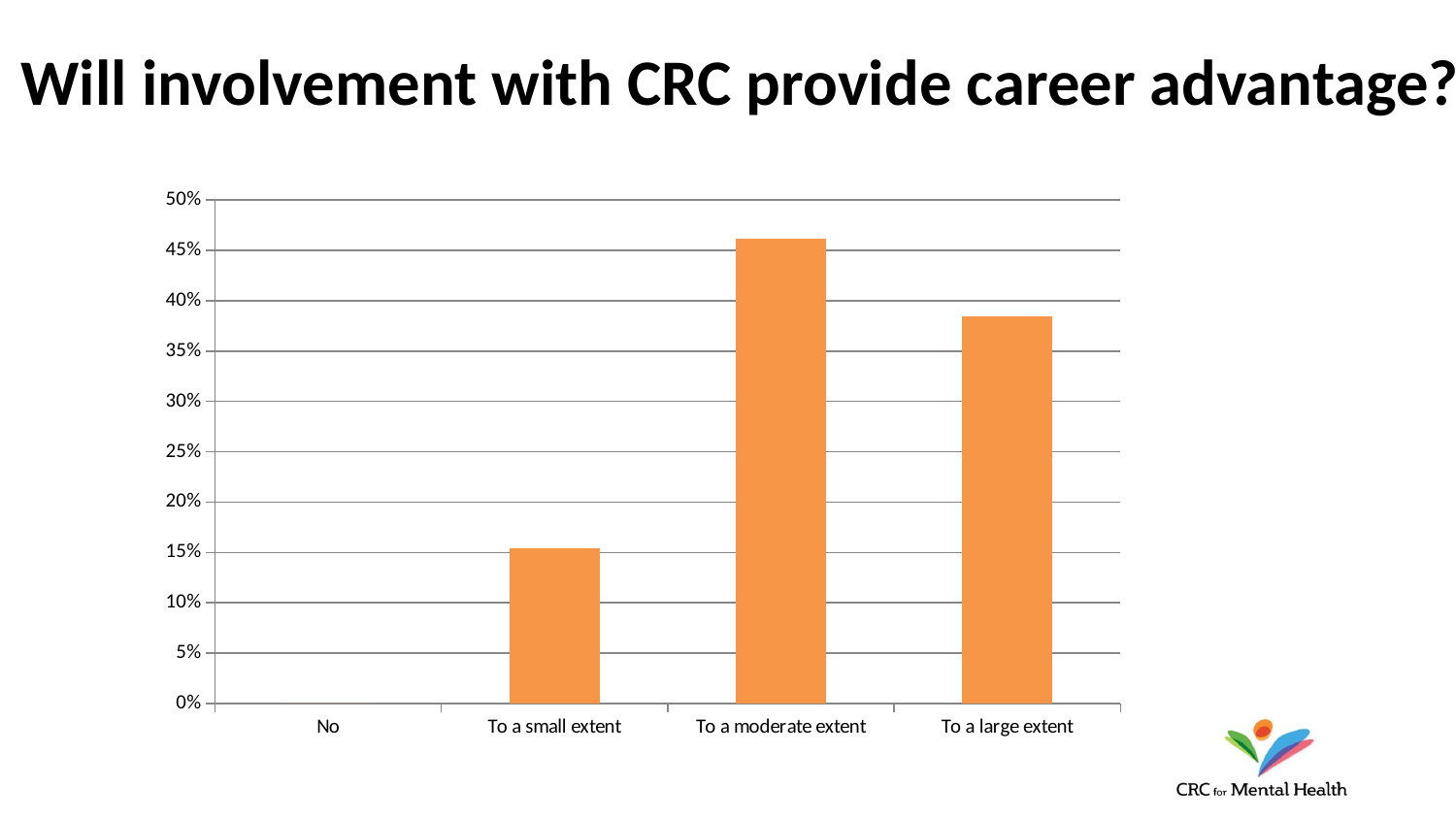
What kind of chart is shown on the slide? bar chart Is the value for "To a moderate extent" greater or less than 45%? greater Which category has the highest value? To a moderate extent Is the value for "To a large extent" greater or less than 40%? less How many categories are shown on the x axis? 4 What is the value for "No"? 0% Which is larger, the value for "To a moderate extent" or the value for "To a large extent"? To a moderate extent Is the value for "To a small extent" greater or less than 20%? less What colour are the bars in the chart? orange What is the title of the chart? Will involvement with CRC provide career advantage? Which category has the lowest value? No Which is larger, the value for "To a small extent" or the value for "To a large extent"? To a large extent